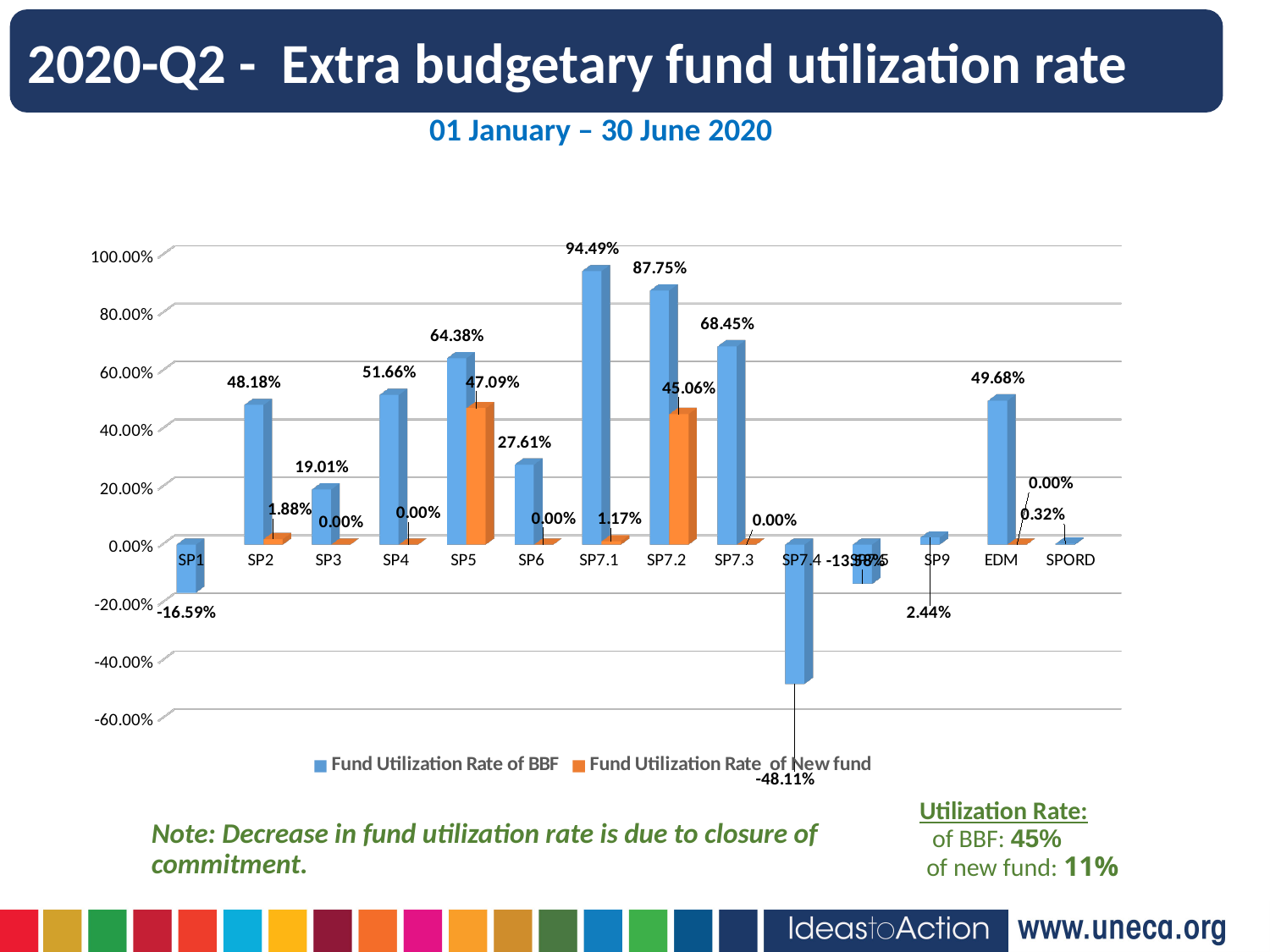
What kind of chart is shown on the slide? bar chart What is the difference between the Fund Utilization Rate of BBF for SP7.1 and SP7.2? 6.74% For SP5, which is larger: the Fund Utilization Rate of BBF or the Fund Utilization Rate of New fund? Fund Utilization Rate of BBF What is the Fund Utilization Rate of BBF for SP1? -16.59% What is the Fund Utilization Rate of BBF for SP7.1? 94.49% What is the difference between the Fund Utilization Rate of BBF and the Fund Utilization Rate of New fund for SP5? 17.29% Which category has the highest Fund Utilization Rate of BBF? SP7.1 Which category has the lowest Fund Utilization Rate of BBF? SP7.4 How many series does the legend list? 2 Which category has the highest Fund Utilization Rate of New fund? SP5 What is the Fund Utilization Rate of BBF for EDM? 49.68% What is the Fund Utilization Rate of New fund for SP5? 47.09%